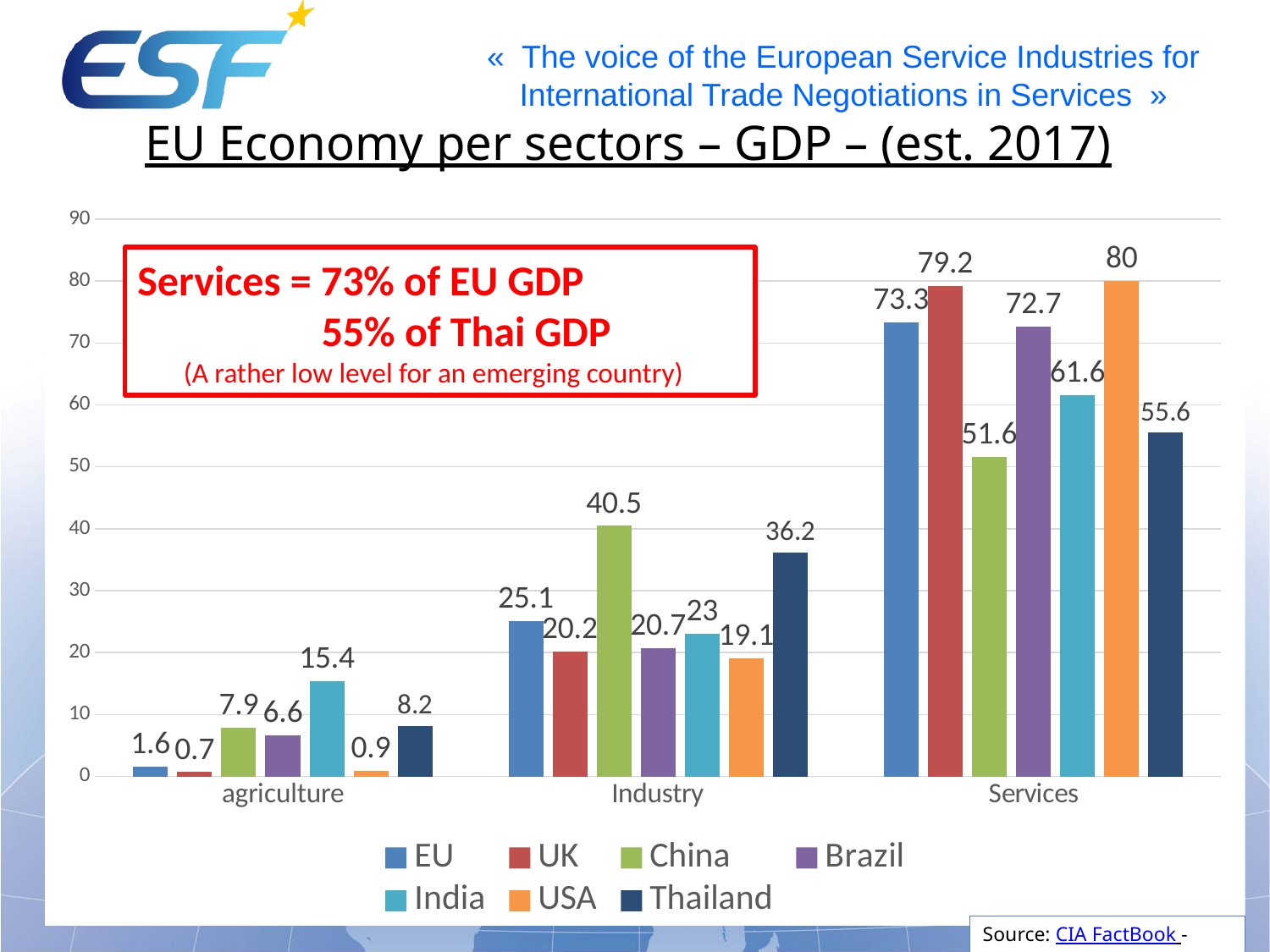
What is the value for Thailand in the Services category? 55.6 What is the value for the EU in the Services category? 73.3 In the Industry category, which is larger: the value for Thailand or the value for the EU? Thailand What kind of chart is shown on the slide? bar chart How many categories are shown on the x axis? 3 What is the difference between the USA and China values in the Services category? 28.4 Which series has the lowest value in the agriculture category? UK How many series does the legend list? 7 What is the value for India in the agriculture category? 15.4 What is the value for China in the Industry category? 40.5 Which series has the highest value in the Services category? USA What is the difference between the China and Thailand values in the Industry category? 4.3